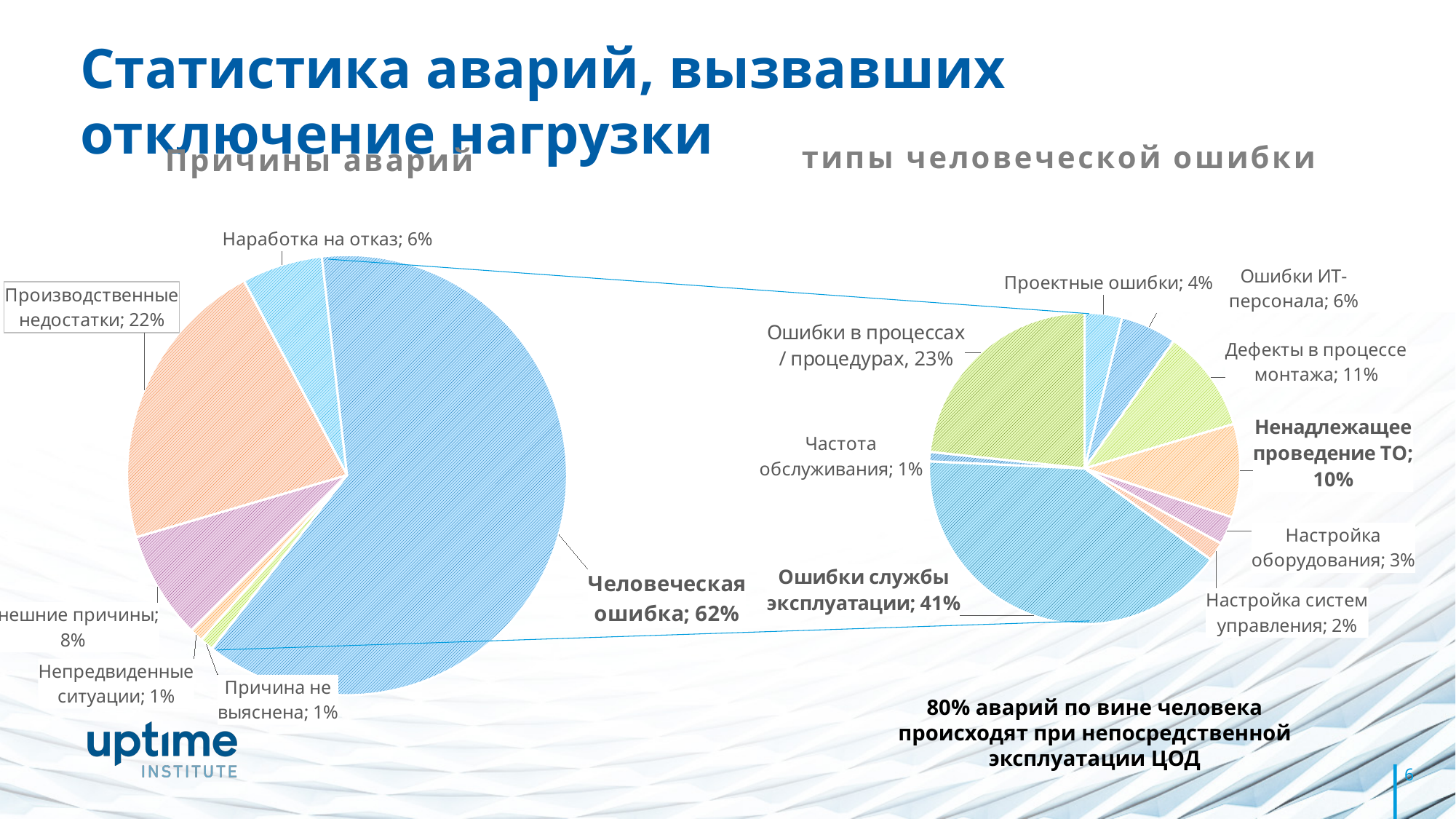
On the 'типы человеческой ошибки' chart, how many slices are labelled? 9 On the 'типы человеческой ошибки' chart, which category has the smallest share? Частота обслуживания What kind of chart is 'Причины аварий'? Pie chart On the 'типы человеческой ошибки' chart, which is larger: 'Ошибки в процессах / процедурах' or 'Ненадлежащее проведение ТО'? Ошибки в процессах / процедурах On the 'Причины аварий' chart, what share is labelled for 'Производственные недостатки'? 22% On the 'типы человеческой ошибки' chart, what share is labelled for 'Ошибки службы эксплуатации'? 41% On the 'Причины аварий' chart, which category has the largest share? Человеческая ошибка On the 'Причины аварий' chart, what share is labelled for 'Человеческая ошибка'? 62% On the 'типы человеческой ошибки' chart, what share is labelled for 'Дефекты в процессе монтажа'? 11% On the 'типы человеческой ошибки' chart, what is the difference between the shares of 'Ошибки службы эксплуатации' and 'Ошибки в процессах / процедурах'? 18% On the 'Причины аварий' chart, what is the difference between the shares of 'Производственные недостатки' and 'Наработка на отказ'? 16% On the 'Причины аварий' chart, how many slices are labelled? 6